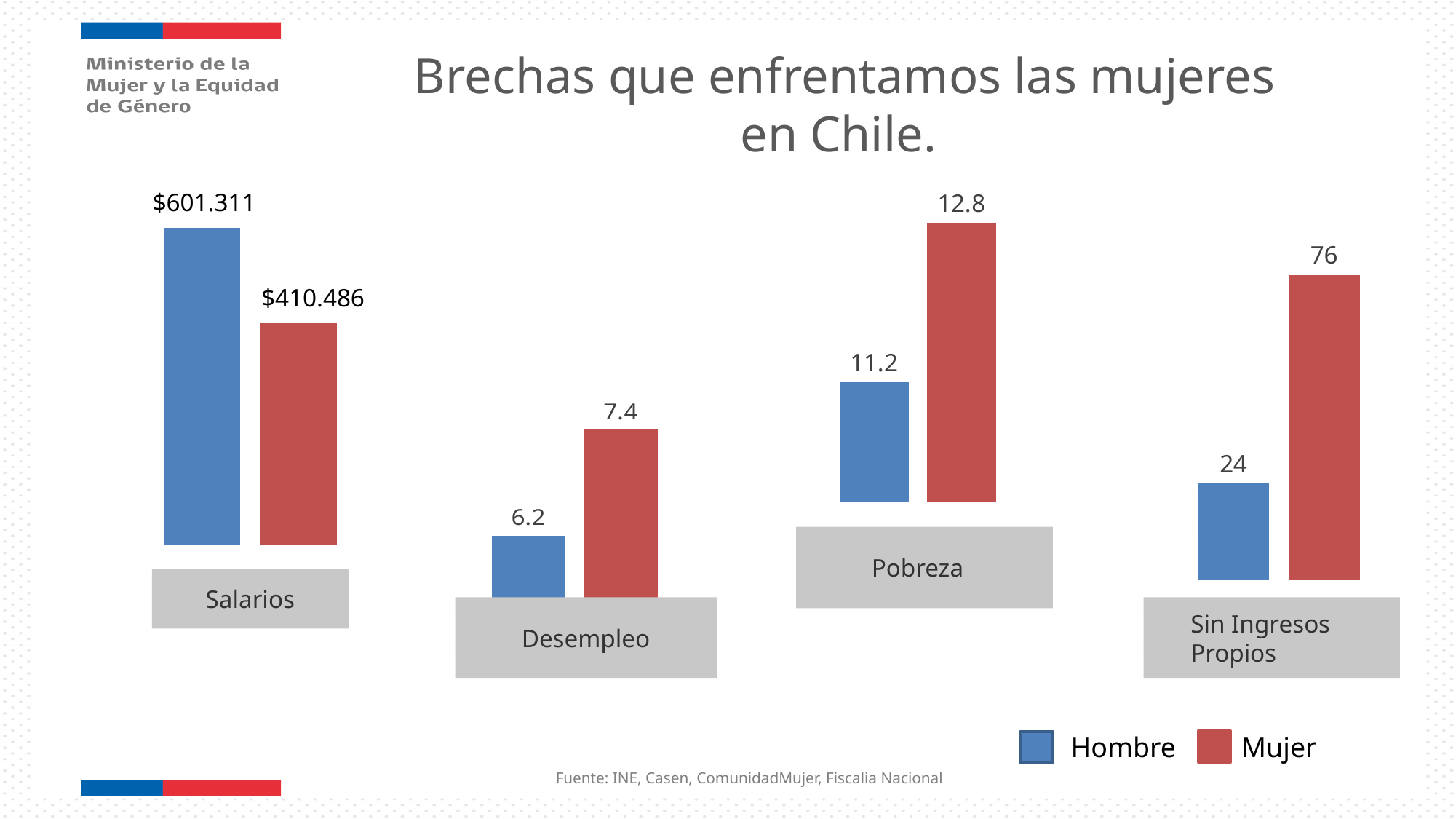
What is the difference between the Mujer and Hombre values in the Sin Ingresos Propios category? 52 What is the value for Mujer in the Desempleo category? 7.4 What is the difference between the Mujer and Hombre values in the Pobreza category? 1.6 What is the value for Hombre in the Pobreza category? 11.2 What is the value for Hombre in the Salarios category? $601.311 What is the difference between the Hombre and Mujer values in the Salarios category? $190.825 What is the value for Mujer in the Sin Ingresos Propios category? 76 How many series does the legend list? 2 In the Desempleo category, which is larger, the Hombre value or the Mujer value? Mujer How many categories are shown on the chart? 4 What is the value for Mujer in the Salarios category? $410.486 What kind of chart is shown on the slide? Bar chart